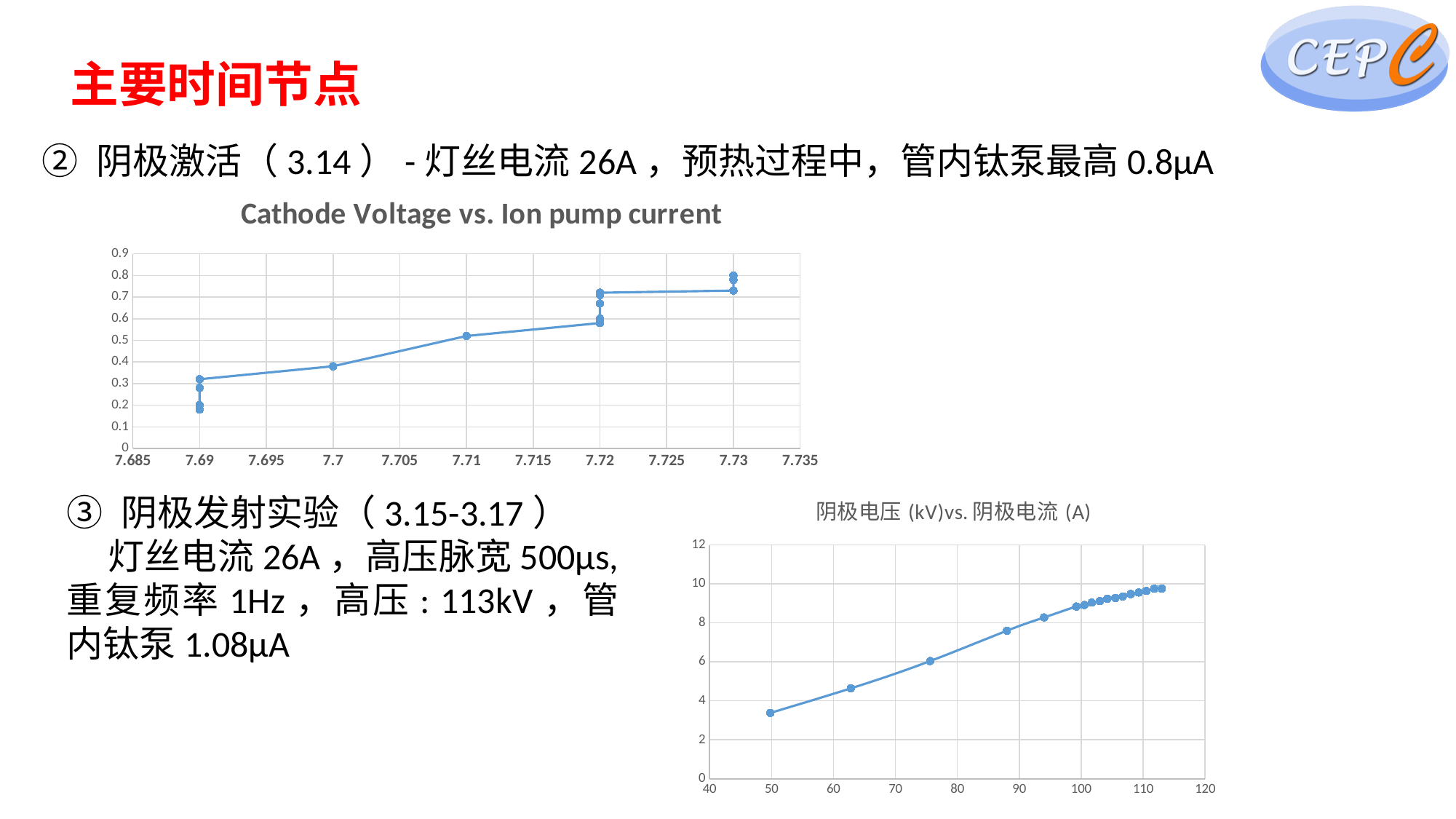
What kind of chart is the '阴极电压 (kV)vs. 阴极电流 (A)' chart? line chart What kind of chart is the 'Cathode Voltage vs. Ion pump current' chart? line chart In the 'Cathode Voltage vs. Ion pump current' chart, is the highest point at x = 7.73 greater or less than 0.7? greater In the '阴极电压 (kV)vs. 阴极电流 (A)' chart, what is the maximum value shown on the x axis? 120 In the 'Cathode Voltage vs. Ion pump current' chart, is the value at x = 7.71 greater or less than 0.6? less In the '阴极电压 (kV)vs. 阴极电流 (A)' chart, is the highest plotted value greater or less than 10? less In the '阴极电压 (kV)vs. 阴极电流 (A)' chart, do the values rise or fall as the x axis increases from 50 to 110? rise In the 'Cathode Voltage vs. Ion pump current' chart, do the values rise or fall as the x axis increases from 7.69 to 7.73? rise In the 'Cathode Voltage vs. Ion pump current' chart, what is the maximum value shown on the y axis? 0.9